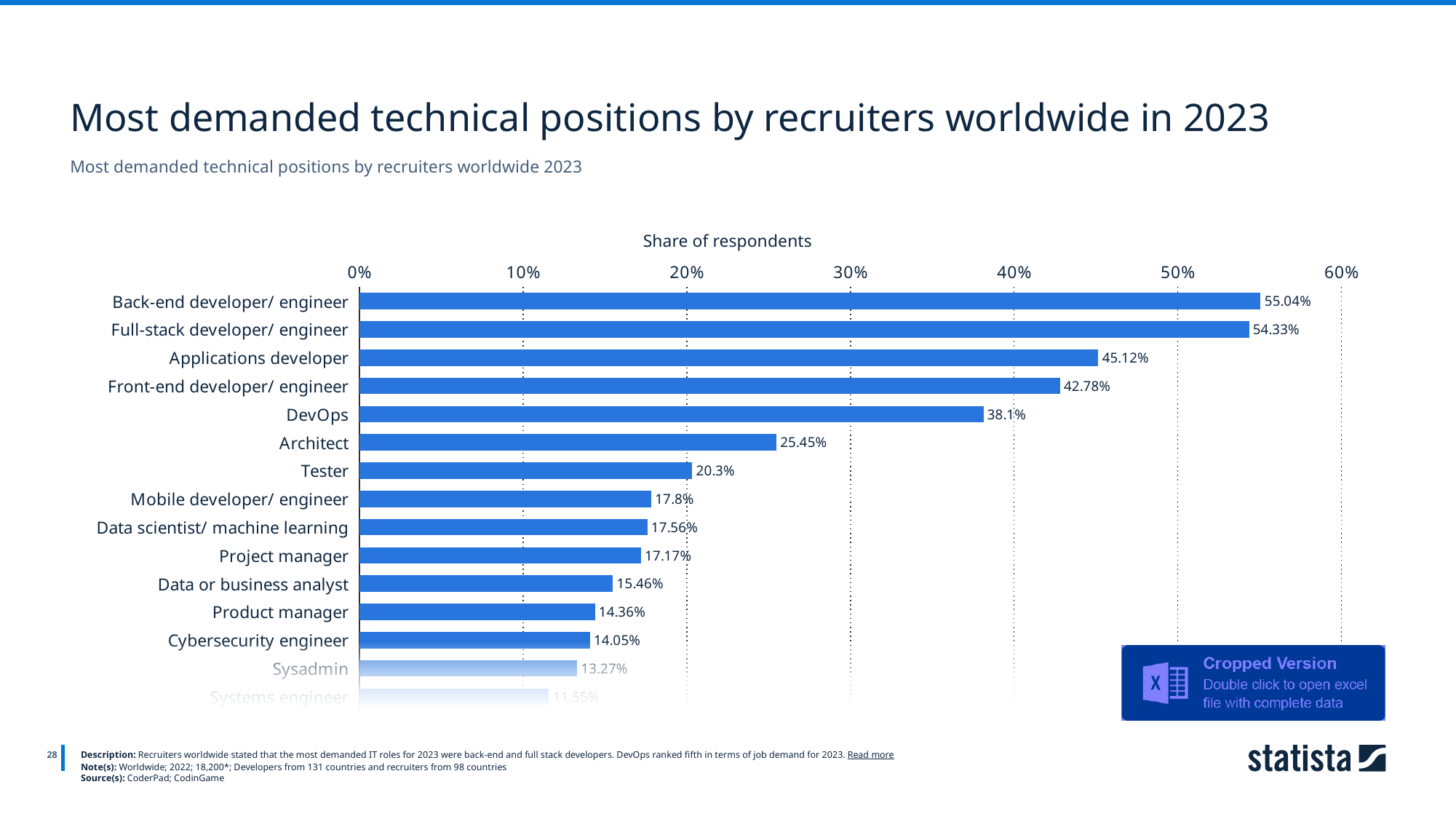
What is the value shown for DevOps? 38.1% What share of respondents named Back-end developer/ engineer as a demanded position? 55.04% Is the value for Architect greater or less than 30%? less What kind of chart is shown on the slide? bar chart What is the value shown for Cybersecurity engineer? 14.05% What is the title of the horizontal axis of the chart? Share of respondents What is the difference in percentage points between Back-end developer/ engineer and Full-stack developer/ engineer? 0.71 Which has a larger share of respondents, Tester or Project manager? Tester Which position has the highest share of respondents? Back-end developer/ engineer What is the difference in percentage points between DevOps and Architect? 12.65 Which has a larger share of respondents, Applications developer or Front-end developer/ engineer? Applications developer What is the value shown for Data scientist/ machine learning? 17.56%